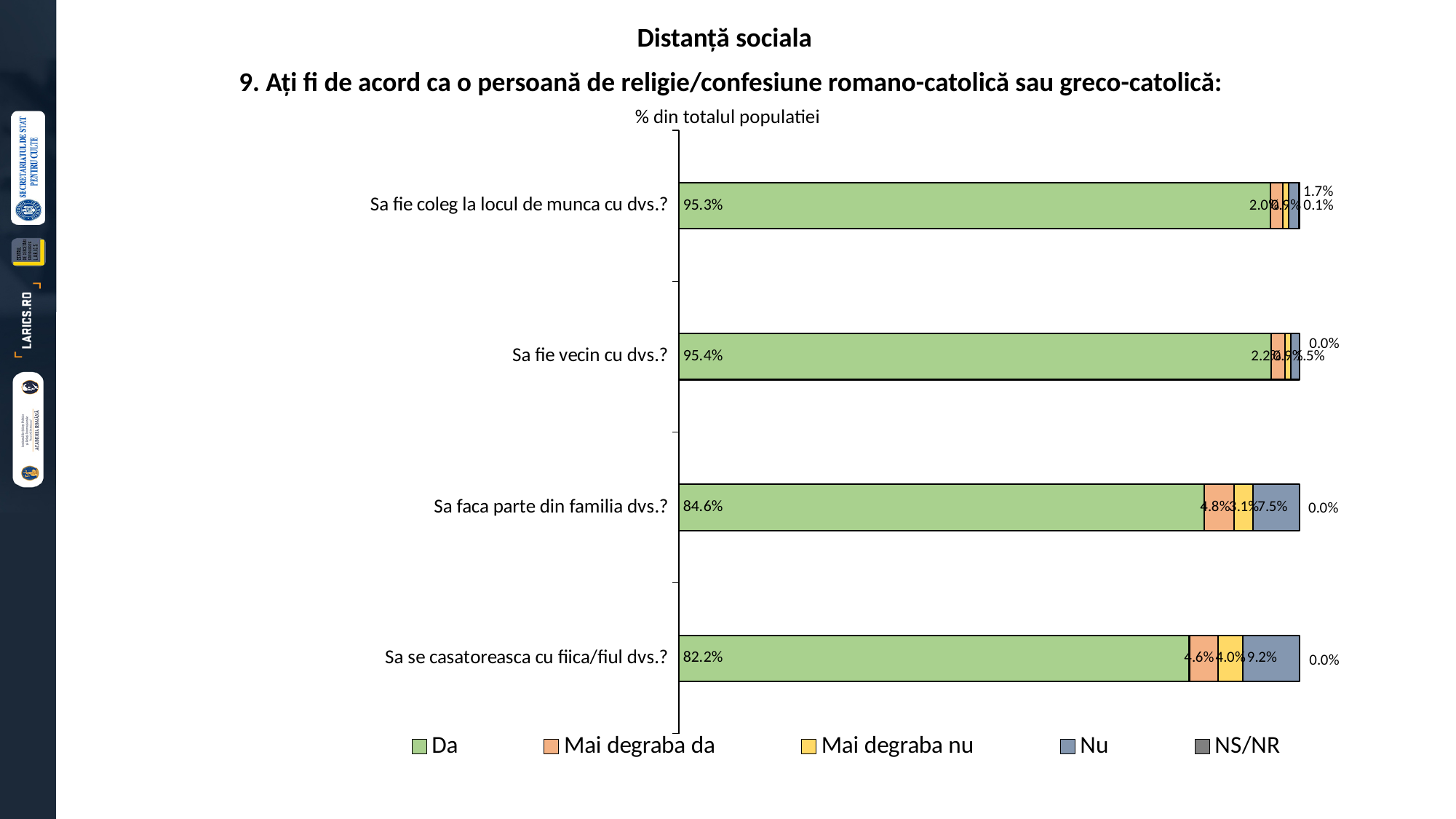
How many categories are shown on the chart? 4 What kind of chart is shown on the slide? Stacked bar chart Which category has the lowest "Da" value? Sa se casatoreasca cu fiica/fiul dvs.? What is the first entry in the chart's legend? Da How many series does the legend list? 5 What is the value of "NS/NR" for "Sa fie coleg la locul de munca cu dvs.?"? 0.1% What is the value of "Mai degraba nu" for "Sa se casatoreasca cu fiica/fiul dvs.?"? 4.0% What is the value of "Da" for "Sa se casatoreasca cu fiica/fiul dvs.?"? 82.2% What is the value of "Nu" for "Sa se casatoreasca cu fiica/fiul dvs.?"? 9.2% What is the difference between the "Da" values for "Sa faca parte din familia dvs.?" and "Sa se casatoreasca cu fiica/fiul dvs.?"? 2.4 percentage points What is the value of "Nu" for "Sa faca parte din familia dvs.?"? 7.5% Which has the larger "Nu" value: "Sa faca parte din familia dvs.?" or "Sa se casatoreasca cu fiica/fiul dvs.?"? Sa se casatoreasca cu fiica/fiul dvs.?